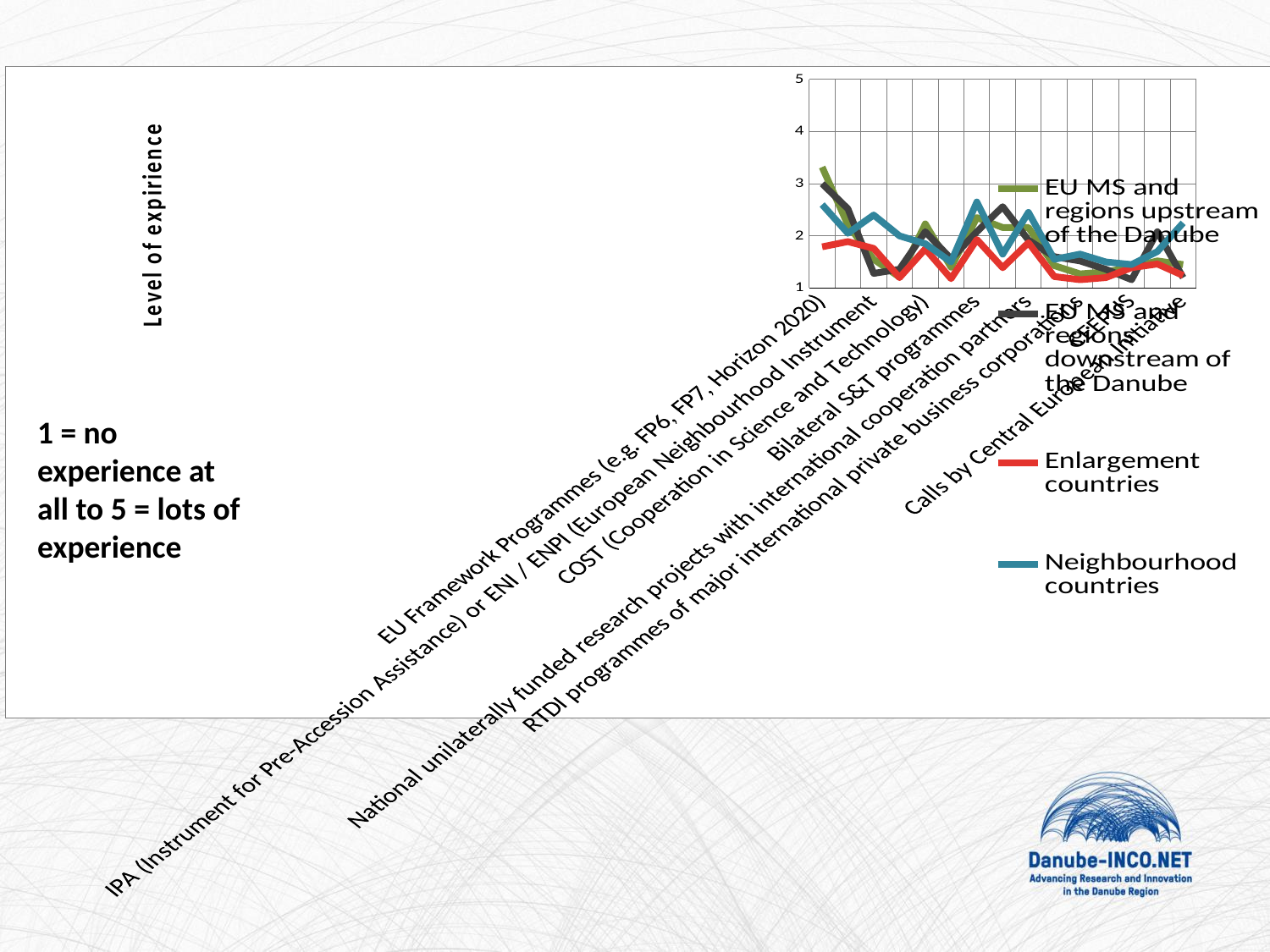
Is the value for Enlargement countries at EU Framework Programmes (e.g. FP6, FP7, Horizon 2020) greater or less than 2? less Is the value for EU MS and regions downstream of the Danube at EU Framework Programmes (e.g. FP6, FP7, Horizon 2020) greater or less than 2? greater Which series has the lowest value at EU Framework Programmes (e.g. FP6, FP7, Horizon 2020)? Enlargement countries How many series does the legend list? 4 Is the value for EU MS and regions upstream of the Danube at EU Framework Programmes (e.g. FP6, FP7, Horizon 2020) greater or less than 3? greater At EU Framework Programmes (e.g. FP6, FP7, Horizon 2020), which is larger: the value for EU MS and regions upstream of the Danube or the value for Enlargement countries? EU MS and regions upstream of the Danube Does the line for EU MS and regions upstream of the Danube generally rise or fall from the first category to the last? fall What is the highest value shown on the vertical axis? 5 What kind of chart is shown on the slide? line chart What is the label of the vertical axis? Level of expirience